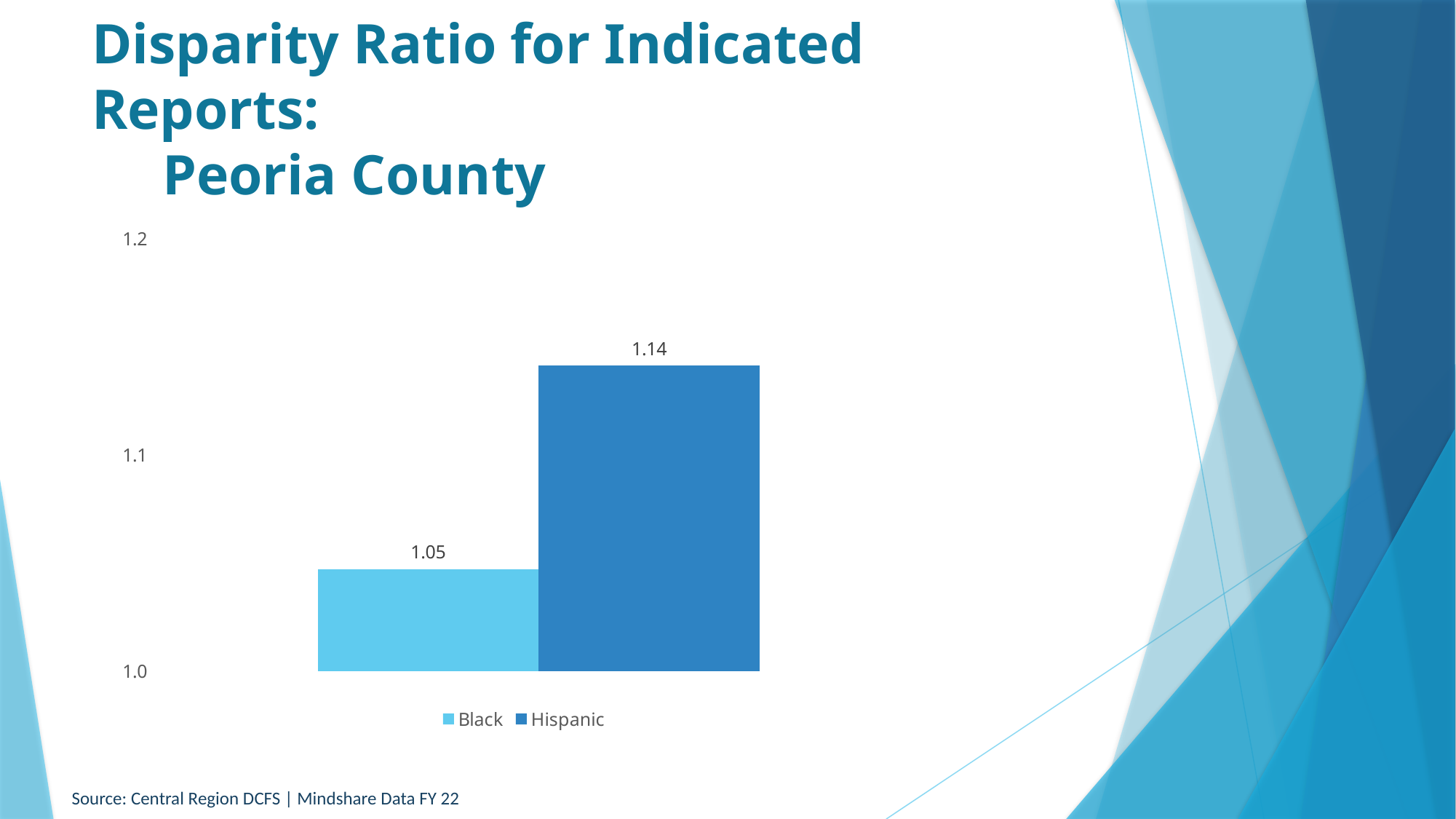
What is the disparity ratio for Hispanic? 1.14 Which group has the higher disparity ratio? Hispanic Is the value for Hispanic greater or less than 1.1? greater How many series does the legend list? 2 Is the value for Black greater or less than 1.1? less What is the disparity ratio for Black? 1.05 What kind of chart is shown on the slide? bar chart What is the source cited for the chart data? Central Region DCFS | Mindshare Data FY 22 Which group has the lower disparity ratio? Black How many bars are plotted in the chart? 2 Is the disparity ratio for Black larger or smaller than the ratio for Hispanic? smaller What is the difference between the Hispanic and Black disparity ratios? 0.09